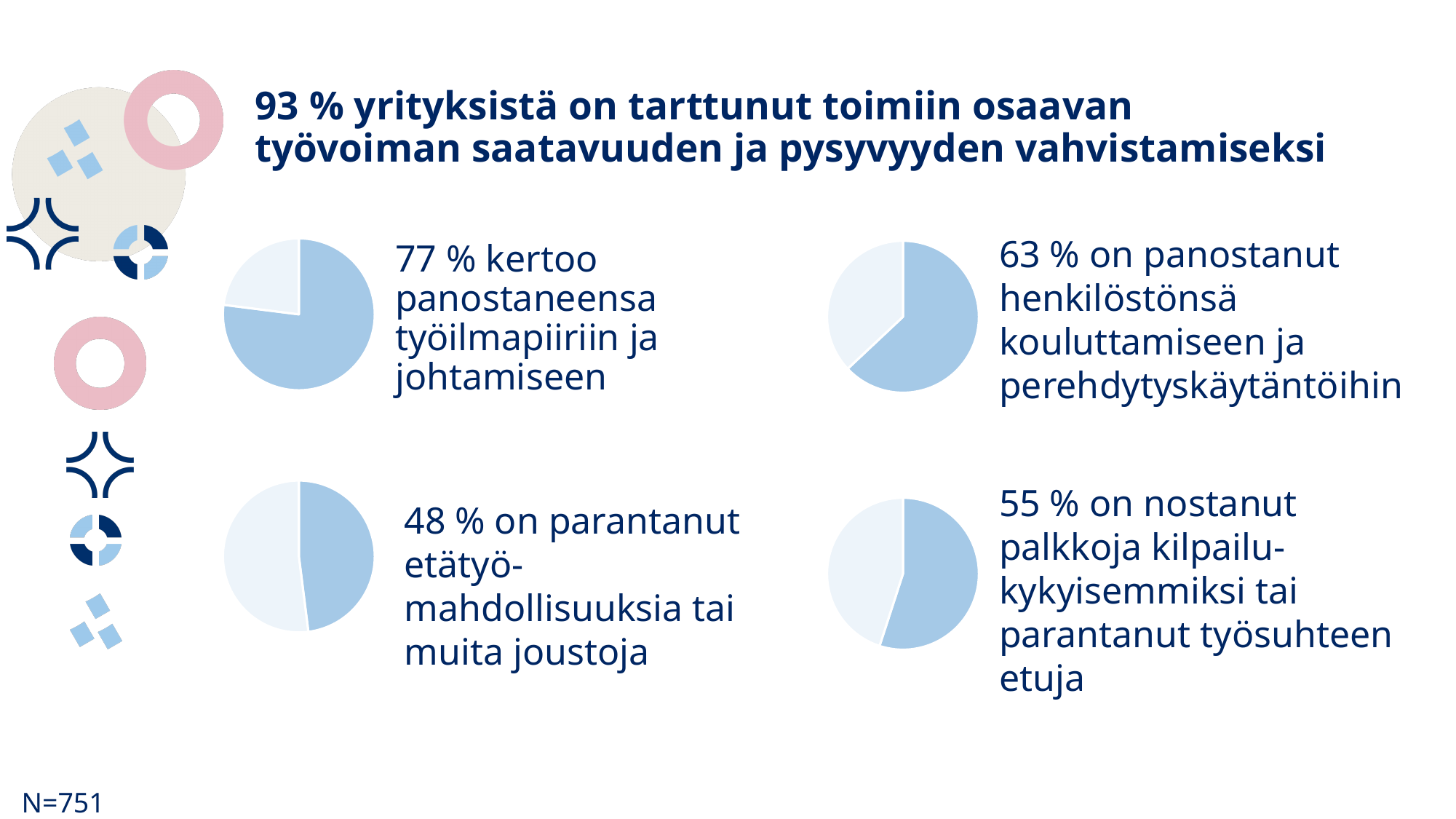
Which of the four pie charts shows the largest highlighted share? The top-left chart (77 %) In the top-right pie chart, what share of companies have invested in training and onboarding practices (kouluttamiseen ja perehdytyskäytäntöihin)? 63 % In the bottom-right pie chart, what share of companies have raised wages or improved employment benefits (nostanut palkkoja)? 55 % Which of the four pie charts shows the smallest highlighted share? The bottom-left chart (48 %) What is the difference between the share in the top-left pie chart (77 %) and the share in the bottom-left pie chart (48 %)? 29 percentage points In the top-left pie chart, what share of companies report investing in work atmosphere and leadership (työilmapiiriin ja johtamiseen)? 77 % Is the highlighted share in the bottom-left pie chart greater or less than 50 %? less What overall percentage of companies does the slide title say have taken action to strengthen the availability and retention of skilled labour? 93 % In the bottom-left pie chart, what share of companies have improved remote work opportunities or other flexibility (etätyömahdollisuuksia tai muita joustoja)? 48 % What kind of charts are shown on the slide? Pie charts How many pie charts are on the slide? 4 Which is larger: the share in the top-right pie chart or the share in the bottom-right pie chart? The top-right pie chart (63 %)